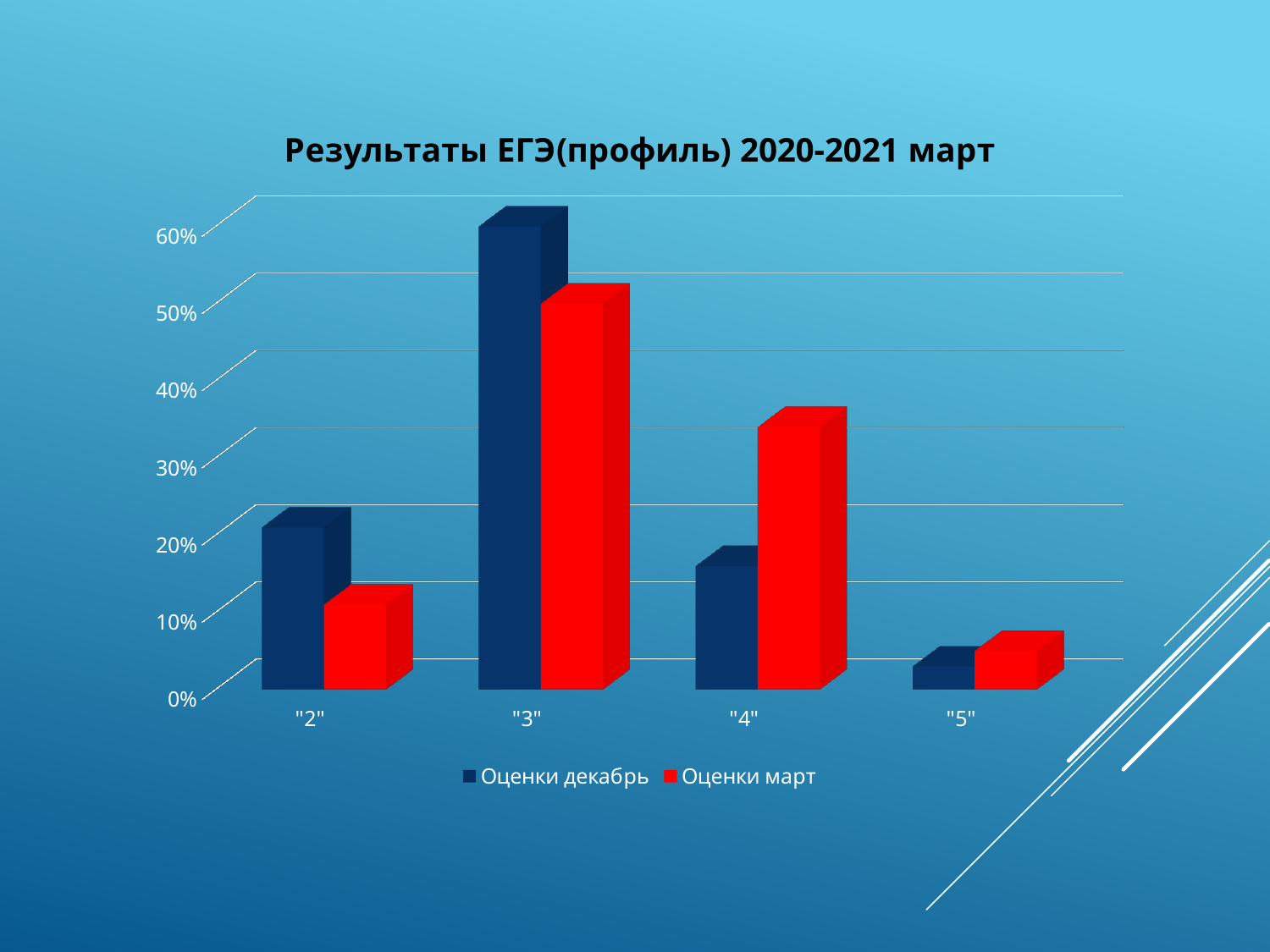
Is the value for Оценки декабрь in category "4" greater or less than 20%? less How many series does the legend list? 2 What is the title of the chart? Результаты ЕГЭ(профиль) 2020-2021 март Which category has the lowest value for Оценки март? "5" Is the value for Оценки март in category "4" greater or less than 30%? greater What kind of chart is shown on the slide? bar chart In category "2", which series has the larger value, Оценки декабрь or Оценки март? Оценки декабрь Is the value for Оценки декабрь in category "5" greater or less than 10%? less Which category has the highest value for Оценки декабрь? "3" In category "4", which series has the larger value, Оценки декабрь or Оценки март? Оценки март How many categories are shown on the x axis? 4